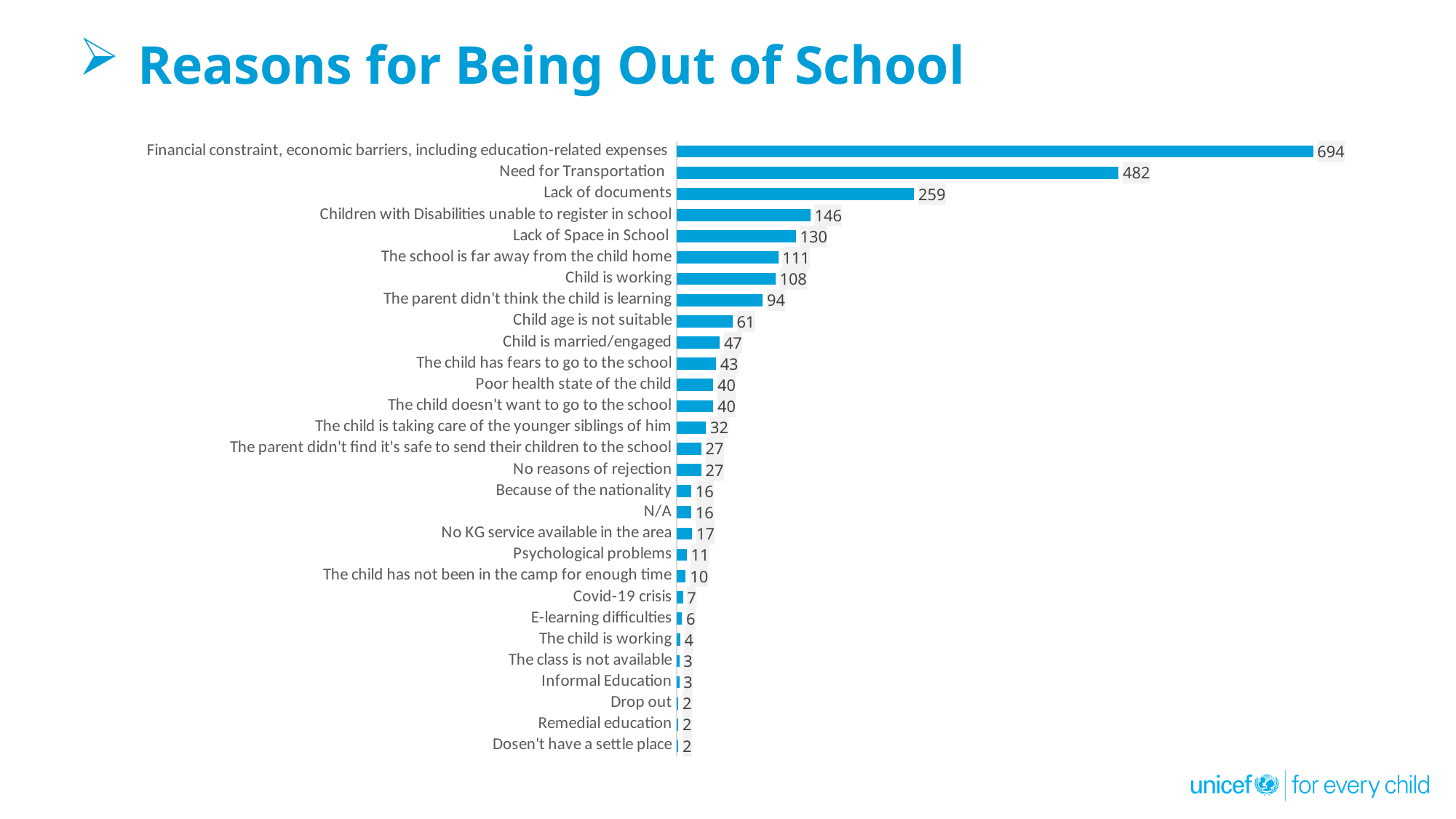
What is the value for "Lack of documents"? 259 What is the title of the slide? Reasons for Being Out of School Which is larger, the value for "The school is far away from the child home" or the value for "Child is working"? The school is far away from the child home How many reasons (categories) are plotted in the chart? 29 What is the value for "Covid-19 crisis"? 7 What is the value for "Child is married/engaged"? 47 What is the value for "Lack of Space in School"? 130 What is the difference between the values for "Financial constraint, economic barriers, including education-related expenses" and "Need for Transportation"? 212 What kind of chart is shown on the slide? bar chart Which reason has the highest value? Financial constraint, economic barriers, including education-related expenses What is the difference between the values for "Children with Disabilities unable to register in school" and "Lack of Space in School"? 16 What is the value for "Need for Transportation"? 482